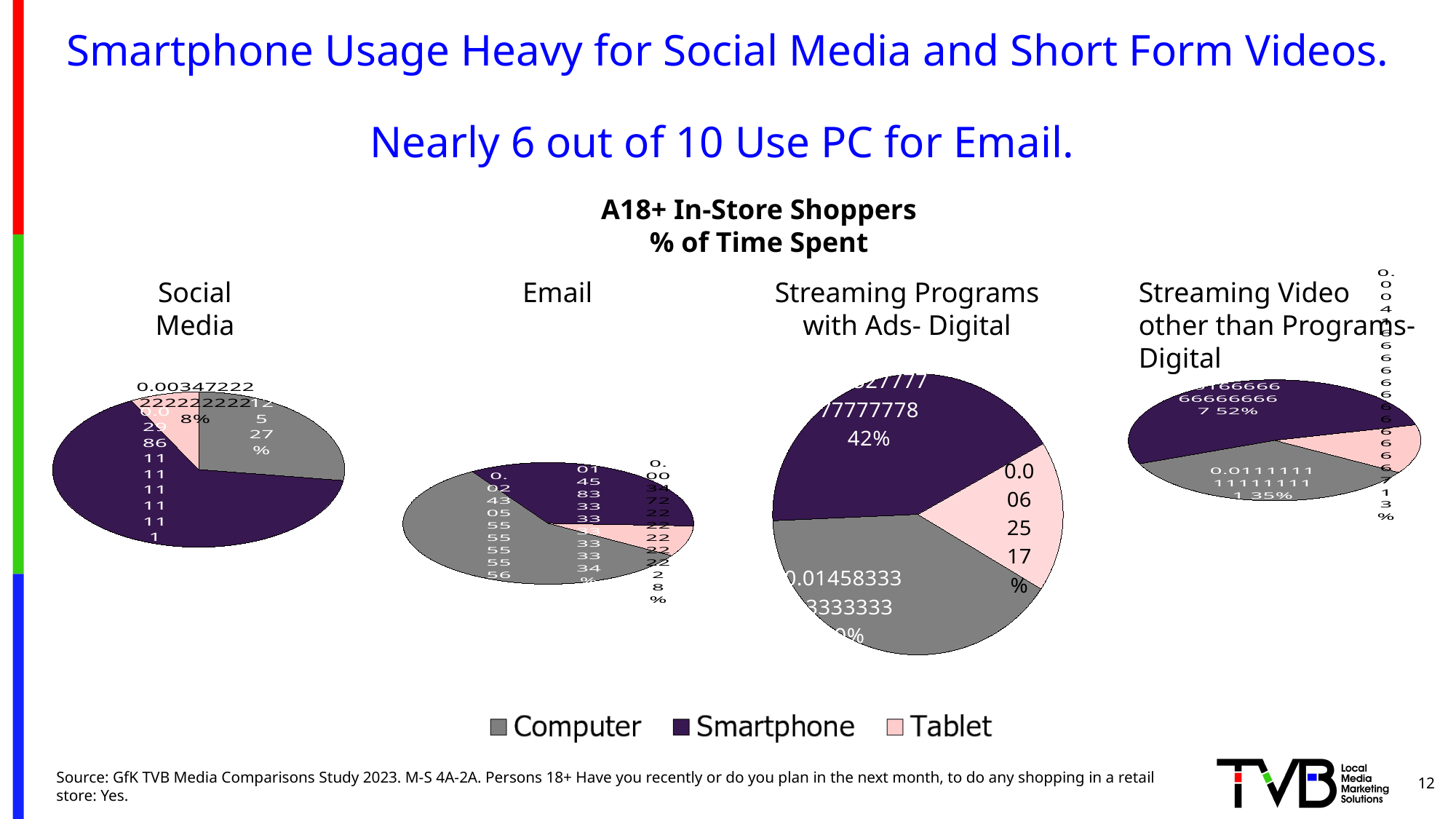
In the Streaming Video other than Programs- Digital pie chart, which device has the smallest slice? Tablet What kind of chart is used on this slide? Pie chart How many pie charts are shown on the slide? 4 In the Social Media pie chart, what is the value for Computer? 27% In the Streaming Video other than Programs- Digital pie chart, what is the value for Smartphone? 52% How many series does the legend list? 3 In the Streaming Programs with Ads- Digital pie chart, what is the value for Smartphone? 42% In the Social Media pie chart, which device has the largest slice? Smartphone In the Social Media pie chart, what is the difference between the Computer and Tablet values? 19% In the Social Media pie chart, what is the value for Tablet? 8% In the Email pie chart, which device has the largest slice? Computer In the Streaming Video other than Programs- Digital pie chart, what is the value for Computer? 35%